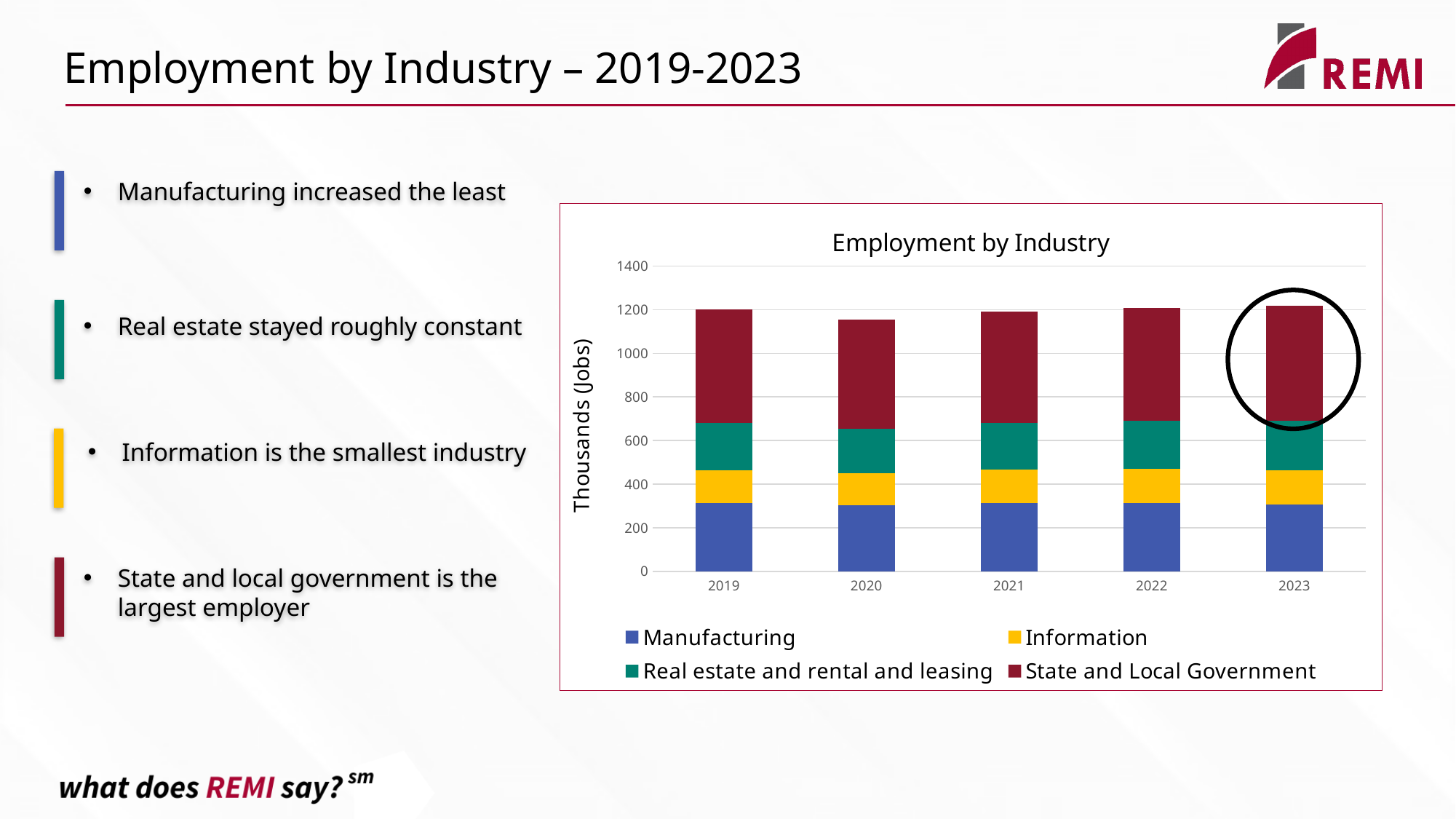
Is the total stacked bar for 2020 greater or less than 1000? greater Which year has the lowest total stacked bar in the chart? 2020 What is the title of the chart? Employment by Industry Is the total stacked bar for 2020 greater or less than 1200? less Is the Manufacturing value for 2019 greater or less than 200? greater How many years are shown on the x axis of the chart? 5 How many series does the chart legend list? 4 Which series forms the largest segment of the 2023 bar? State and Local Government In 2021, which segment is larger: Manufacturing or Information? Manufacturing What kind of chart is shown on the slide? Stacked bar chart What is the label on the vertical axis of the chart? Thousands (Jobs) Which series forms the smallest segment of the 2019 bar? Information